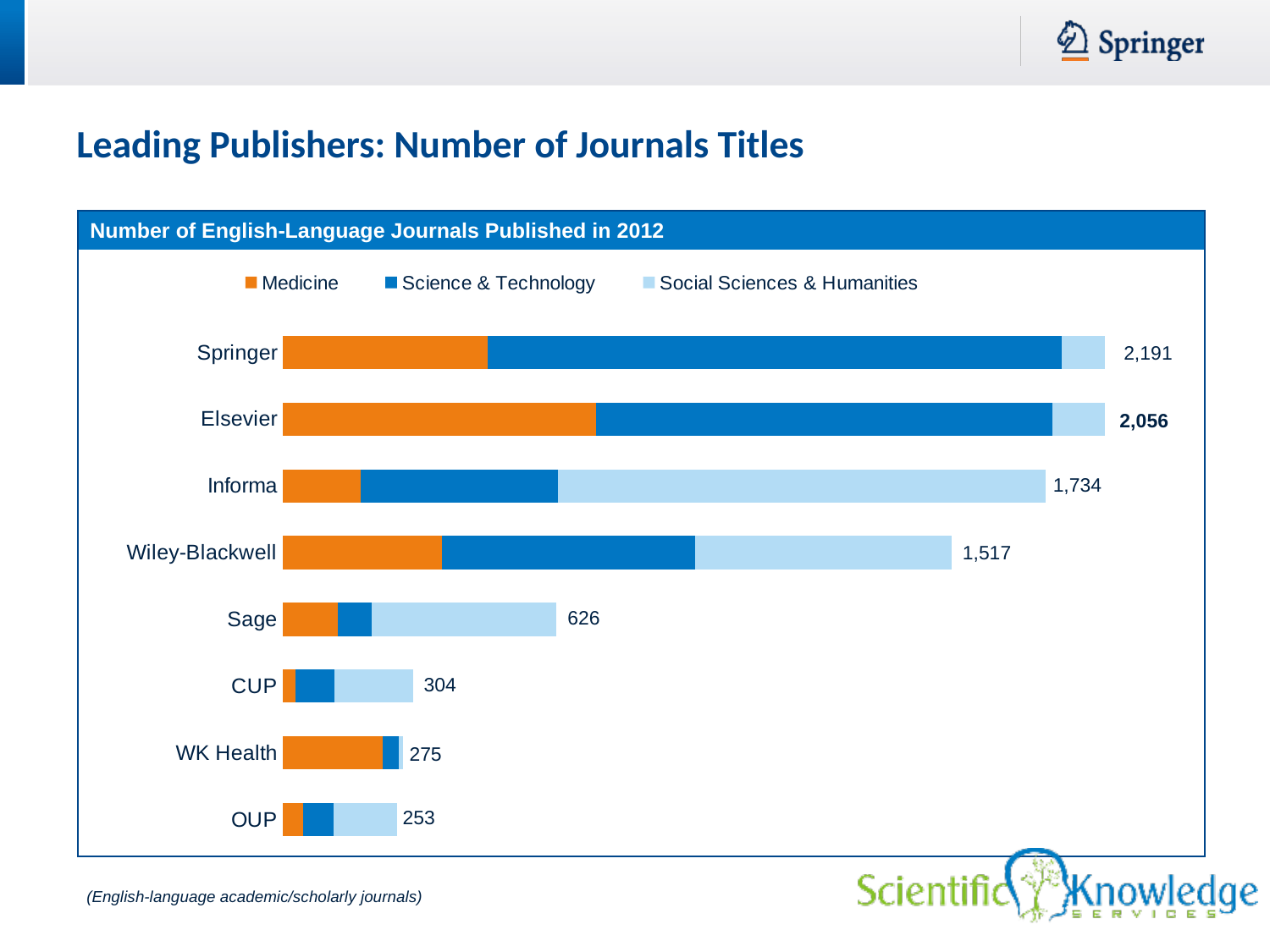
Which has a larger total, Sage or CUP? Sage What is the difference between the totals for Informa and Wiley-Blackwell? 217 What kind of chart is shown on the slide? Stacked bar chart What is the total number of journals shown for Wiley-Blackwell? 1,517 Which publisher has the highest total number of journals? Springer How many series does the legend list? 3 What is the total number of journals shown for OUP? 253 What is the difference between the totals for Springer and Elsevier? 135 How many publishers are shown in the chart? 8 What is the total number of journals shown for Elsevier? 2,056 What is the total number of English-language journals published in 2012 for Springer? 2,191 Which publisher has the lowest total number of journals? OUP